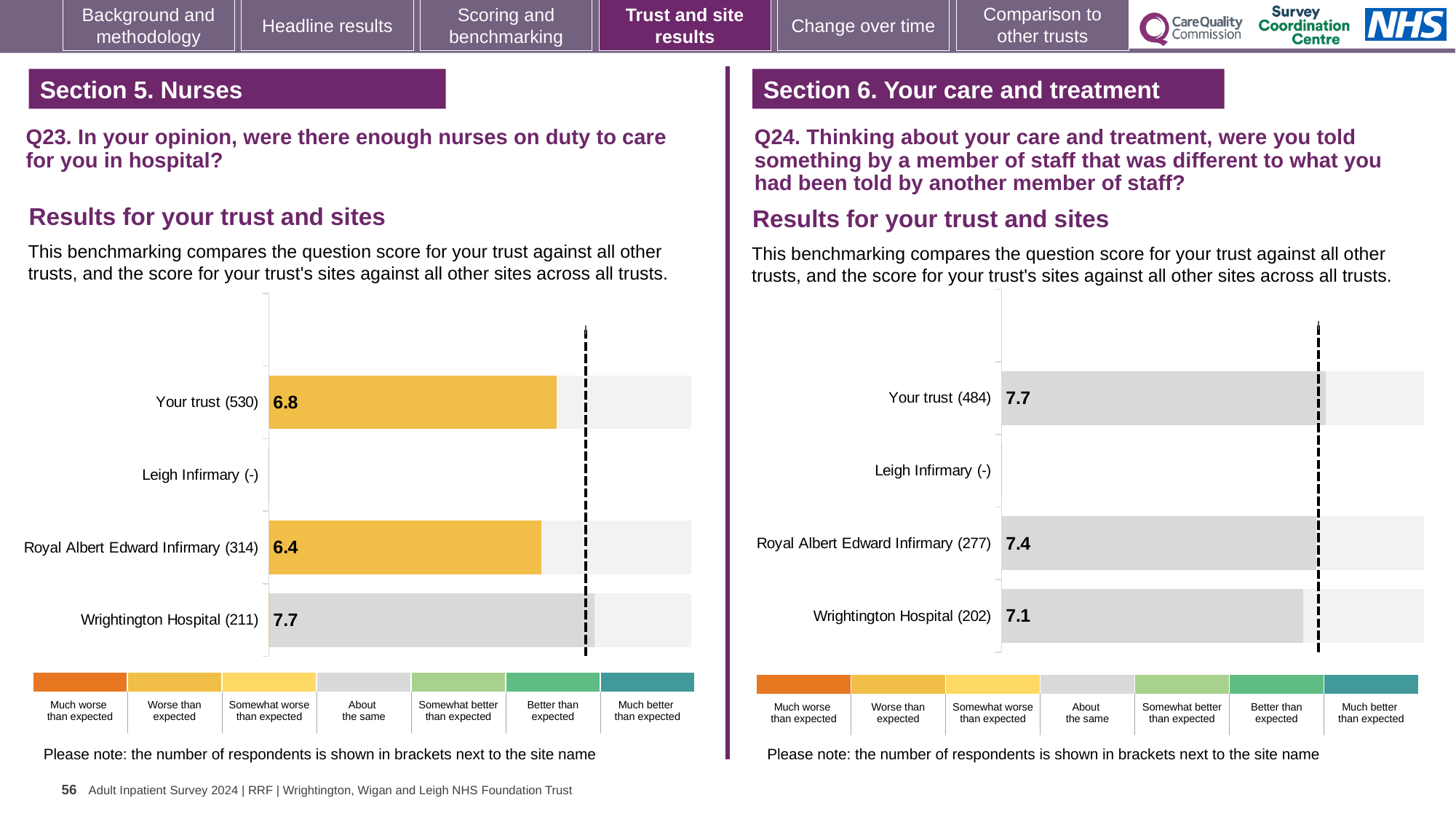
In the Q24 chart (right), what is the difference between the scores for Your trust and Wrightington Hospital? 0.6 In the Q23 chart (left), what is the score for Royal Albert Edward Infirmary? 6.4 In the Q24 chart (right), what is the score for Your trust? 7.7 In the Q23 chart (left), which benchmark category does the colour of the Your trust bar correspond to in the legend? Worse than expected In the Q23 chart (left), how many respondents are shown for Your trust? 530 In the Q23 chart (left), which site or trust has the highest score? Wrightington Hospital In the Q23 chart (left), what is the score for Your trust? 6.8 What kind of chart is used in the Q23 chart (left)? Bar chart In the Q24 chart (right), what is the score for Wrightington Hospital? 7.1 In the Q24 chart (right), which of Royal Albert Edward Infirmary or Wrightington Hospital has the higher score? Royal Albert Edward Infirmary In the Q24 chart (right), how many respondents are shown for Royal Albert Edward Infirmary? 277 In the Q23 chart (left), what is the difference between the scores for Wrightington Hospital and Royal Albert Edward Infirmary? 1.3